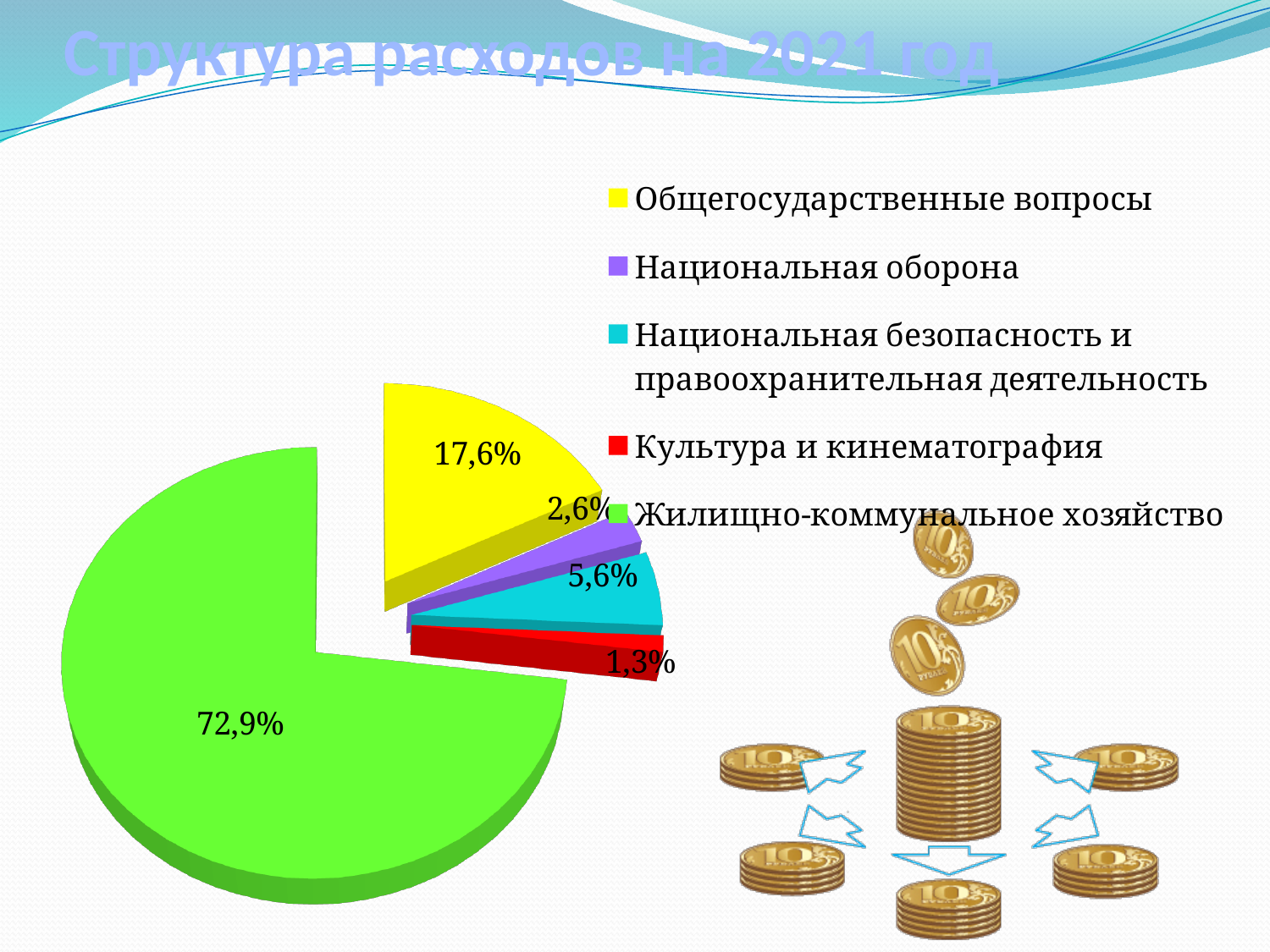
What is the share for Жилищно-коммунальное хозяйство? 72,9% What is the title of the chart? Структура расходов на 2021 год Which category has the smallest share of the pie? Культура и кинематография What is the share for Национальная оборона? 2,6% What is the share for Национальная безопасность и правоохранительная деятельность? 5,6% What kind of chart is shown on the slide? pie chart Which category has the largest share of the pie? Жилищно-коммунальное хозяйство How many categories does the legend list? 5 What is the difference between the shares for Общегосударственные вопросы and Национальная безопасность и правоохранительная деятельность? 12,0 percentage points Which is larger: the share for Национальная оборона or the share for Национальная безопасность и правоохранительная деятельность? Национальная безопасность и правоохранительная деятельность What is the share for Культура и кинематография? 1,3% What is the share for Общегосударственные вопросы? 17,6%